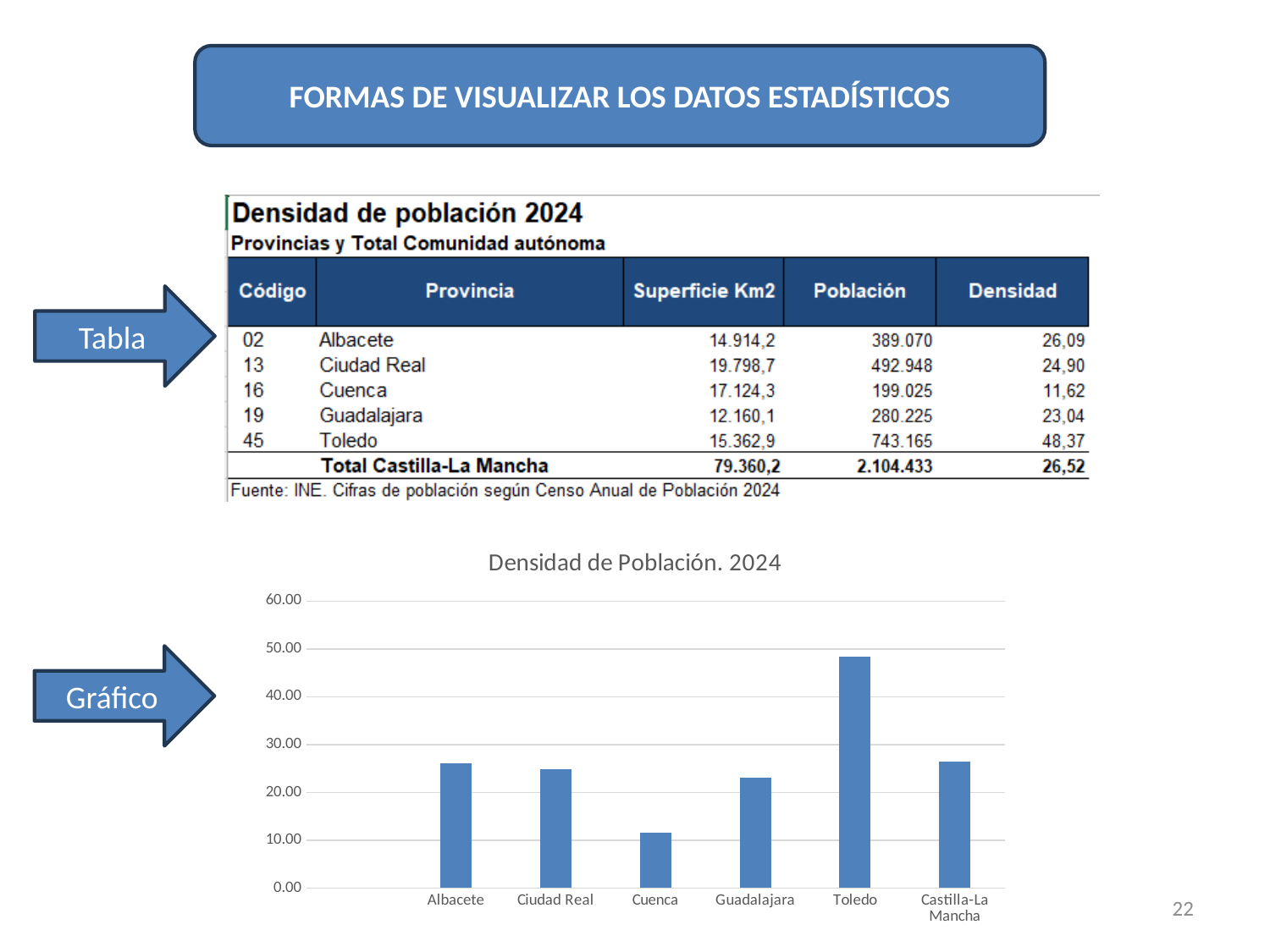
What kind of chart is shown under the title 'Densidad de Población. 2024'? bar chart How many categories are plotted on the x axis of the chart 'Densidad de Población. 2024'? 6 In the chart 'Densidad de Población. 2024', which category has the lowest bar? Cuenca What is the highest value shown on the y axis of the chart 'Densidad de Población. 2024'? 60.00 What is the title of the bar chart on the slide? Densidad de Población. 2024 In the chart 'Densidad de Población. 2024', is the value for Albacete greater or less than 30.00? less In the chart 'Densidad de Población. 2024', which is larger, the value for Toledo or the value for Ciudad Real? Toledo In the chart 'Densidad de Población. 2024', is the value for Cuenca greater or less than 20.00? less In the chart 'Densidad de Población. 2024', is the value for Toledo greater or less than 40.00? greater In the chart 'Densidad de Población. 2024', which category has the highest bar? Toledo In the chart 'Densidad de Población. 2024', which is larger, the value for Cuenca or the value for Guadalajara? Guadalajara